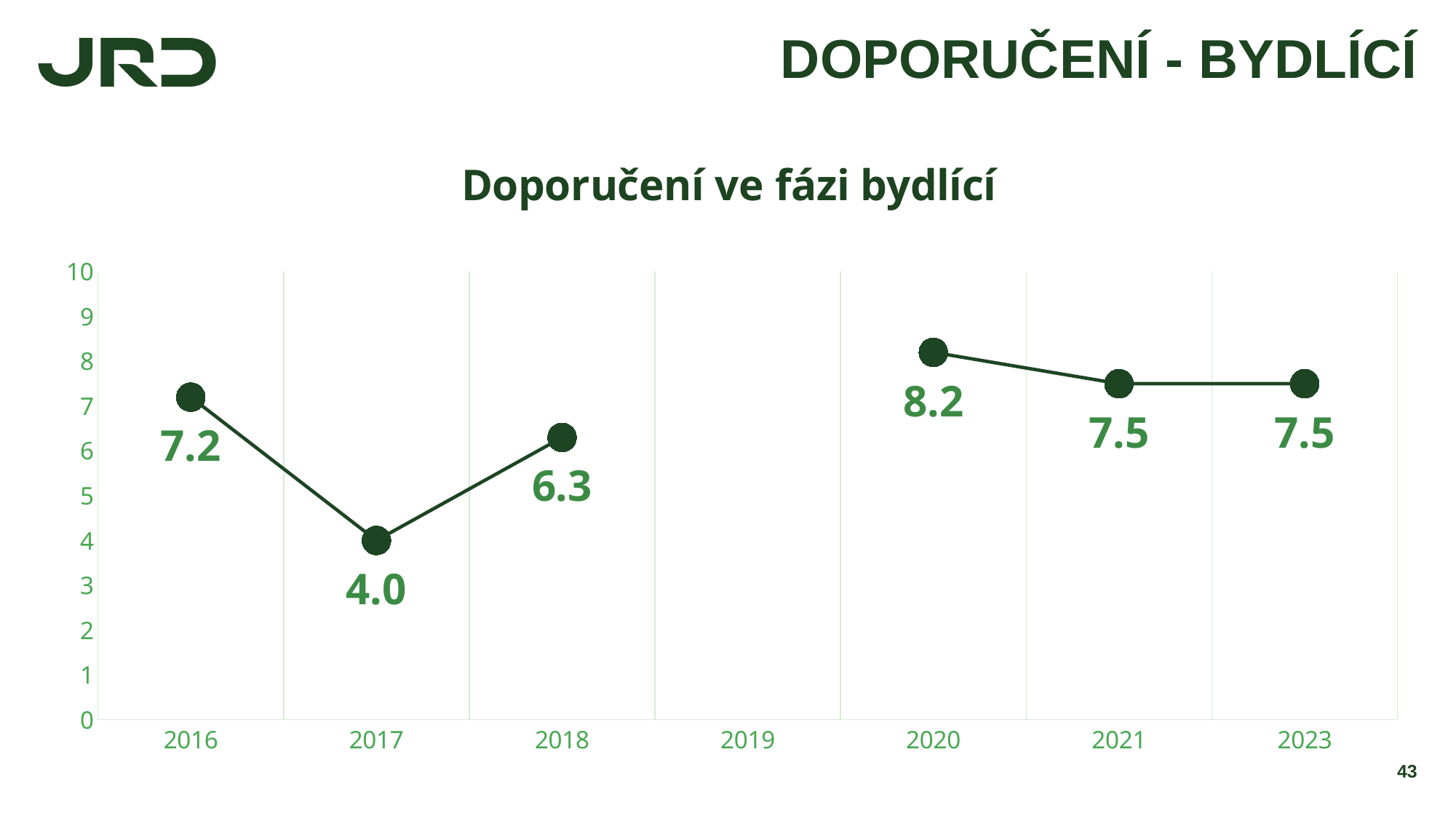
How many years are labelled on the x axis? 7 Which year has the lowest value? 2017 What is the value for 2020? 8.2 Is the value for 2018 greater or less than 5? greater What is the value for 2016? 7.2 What is the difference between the values for 2020 and 2017? 4.2 What is the title of the chart? Doporučení ve fázi bydlící What is the value for 2017? 4.0 Which is larger, the value for 2016 or the value for 2018? 2016 What kind of chart is shown? line chart Do the values rise or fall from 2020 to 2021? fall Which year has the highest value? 2020